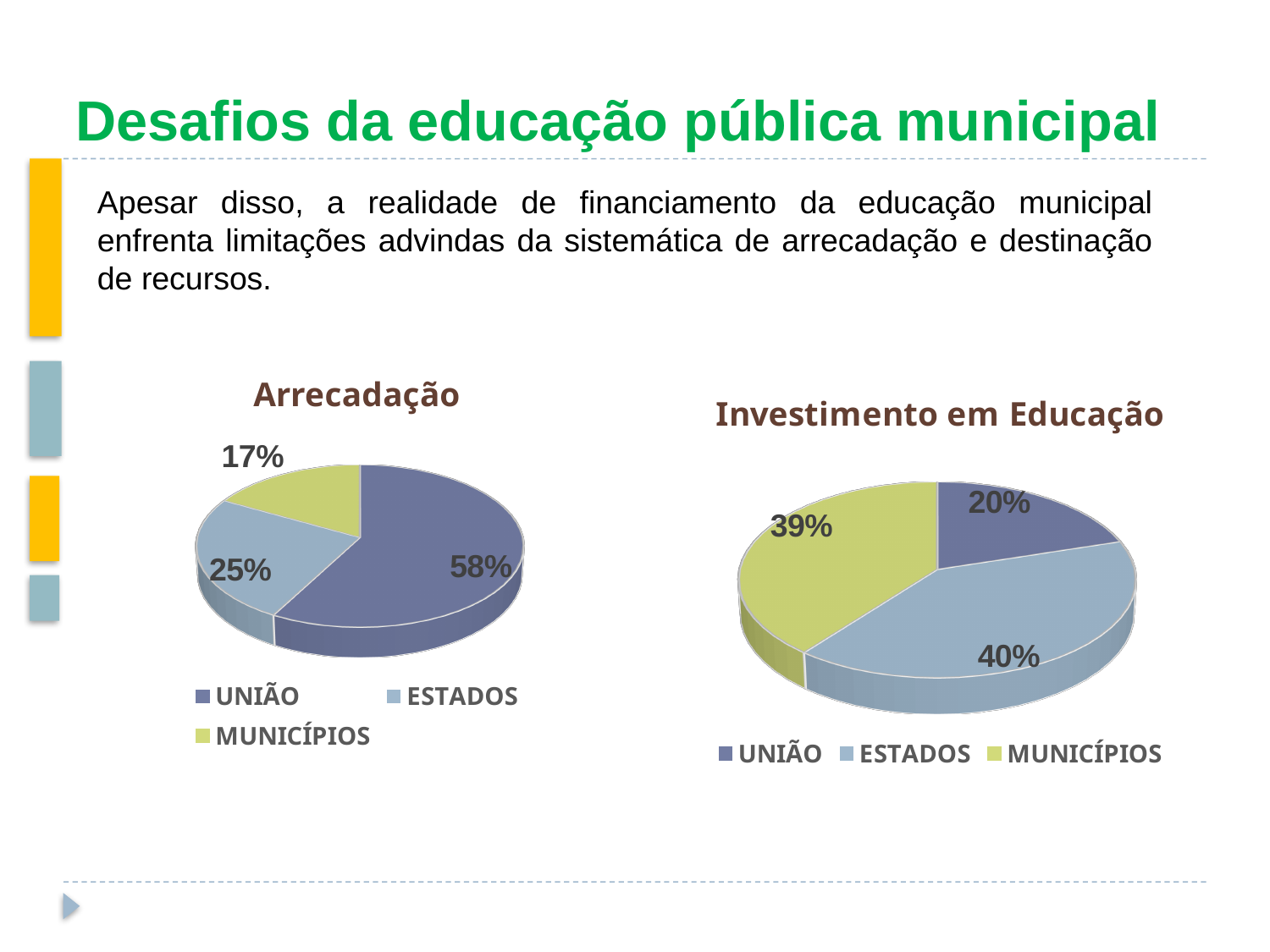
In the Arrecadação chart, what share does UNIÃO have? 58% What type of chart is the Arrecadação chart? Pie chart In the Arrecadação chart, what share does ESTADOS have? 25% In the Arrecadação chart, what share does MUNICÍPIOS have? 17% In the Investimento em Educação chart, what share does UNIÃO have? 20% In the Investimento em Educação chart, which category has the smallest share? UNIÃO In the Investimento em Educação chart, which is larger, the share for ESTADOS or the share for UNIÃO? ESTADOS How many categories does the legend of the Investimento em Educação chart list? 3 In the Arrecadação chart, which category has the largest share? UNIÃO In the Arrecadação chart, what is the difference between the UNIÃO share and the ESTADOS share? 33% In the Investimento em Educação chart, what share does MUNICÍPIOS have? 39% In the Investimento em Educação chart, what share does ESTADOS have? 40%